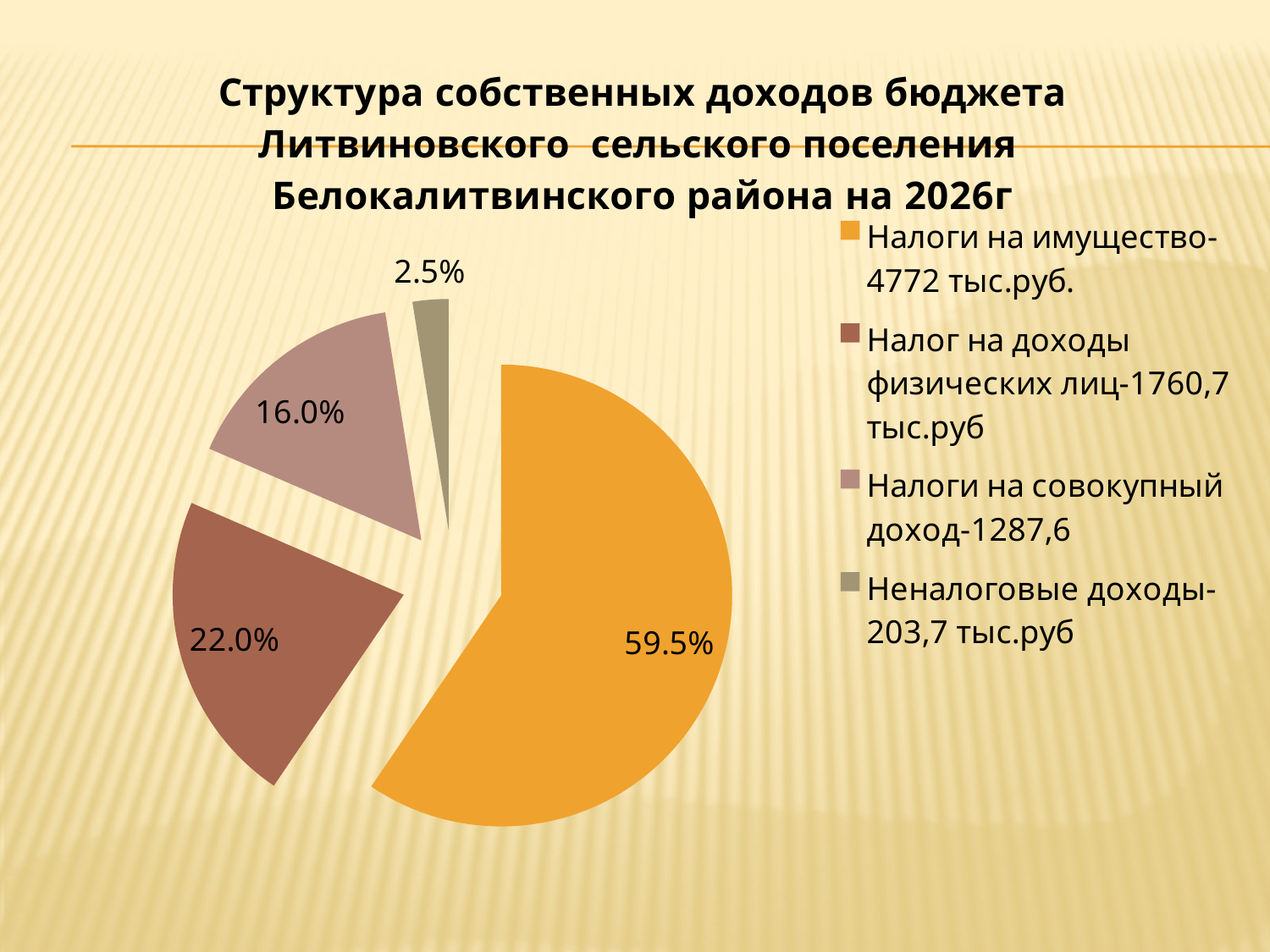
What share of the pie does "Налоги на совокупный доход" take? 16.0% What share of the pie does "Налоги на имущество" take? 59.5% According to the legend, what amount in тыс.руб. corresponds to "Налоги на имущество"? 4772 тыс.руб. What share of the pie does "Неналоговые доходы" take? 2.5% What colour is the slice for "Неналоговые доходы"? grey-olive Which slice is larger: "Налоги на совокупный доход" or "Неналоговые доходы"? Налоги на совокупный доход How many slices does the pie chart have? 4 Which category has the smallest slice of the pie? Неналоговые доходы Which category has the largest slice of the pie? Налоги на имущество What kind of chart is shown on the slide? pie chart What is the difference in percentage points between the shares of "Налог на доходы физических лиц" and "Налоги на совокупный доход"? 6.0